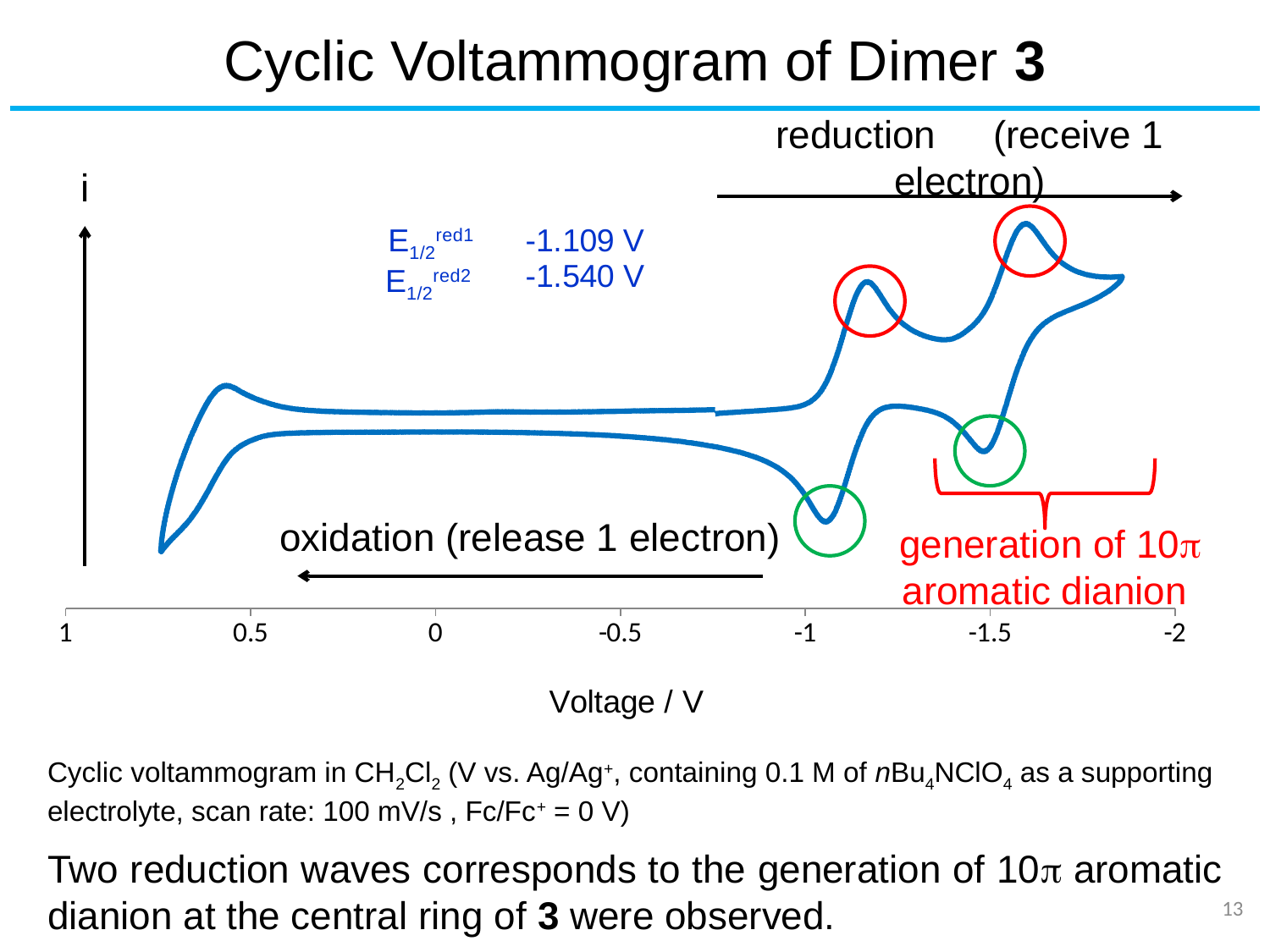
Which half-wave potential is more negative, E1/2 red1 or E1/2 red2? E1/2 red2 What is the value of E1/2 red2 printed on the chart? -1.540 V What is the value of E1/2 red1 printed on the chart? -1.109 V What kind of chart is shown on the slide? line chart Is the value of E1/2 red2 greater or less than -1.5 V? less What is the difference between E1/2 red1 and E1/2 red2? 0.431 V What does the red bracket annotation under the reduction waves say? generation of 10π aromatic dianion How many reduction waves are marked with red circles on the voltammogram? 2 How many tick labels are shown on the voltage axis? 7 Is the value of E1/2 red1 greater or less than -1 V? less What is the label of the horizontal axis? Voltage / V